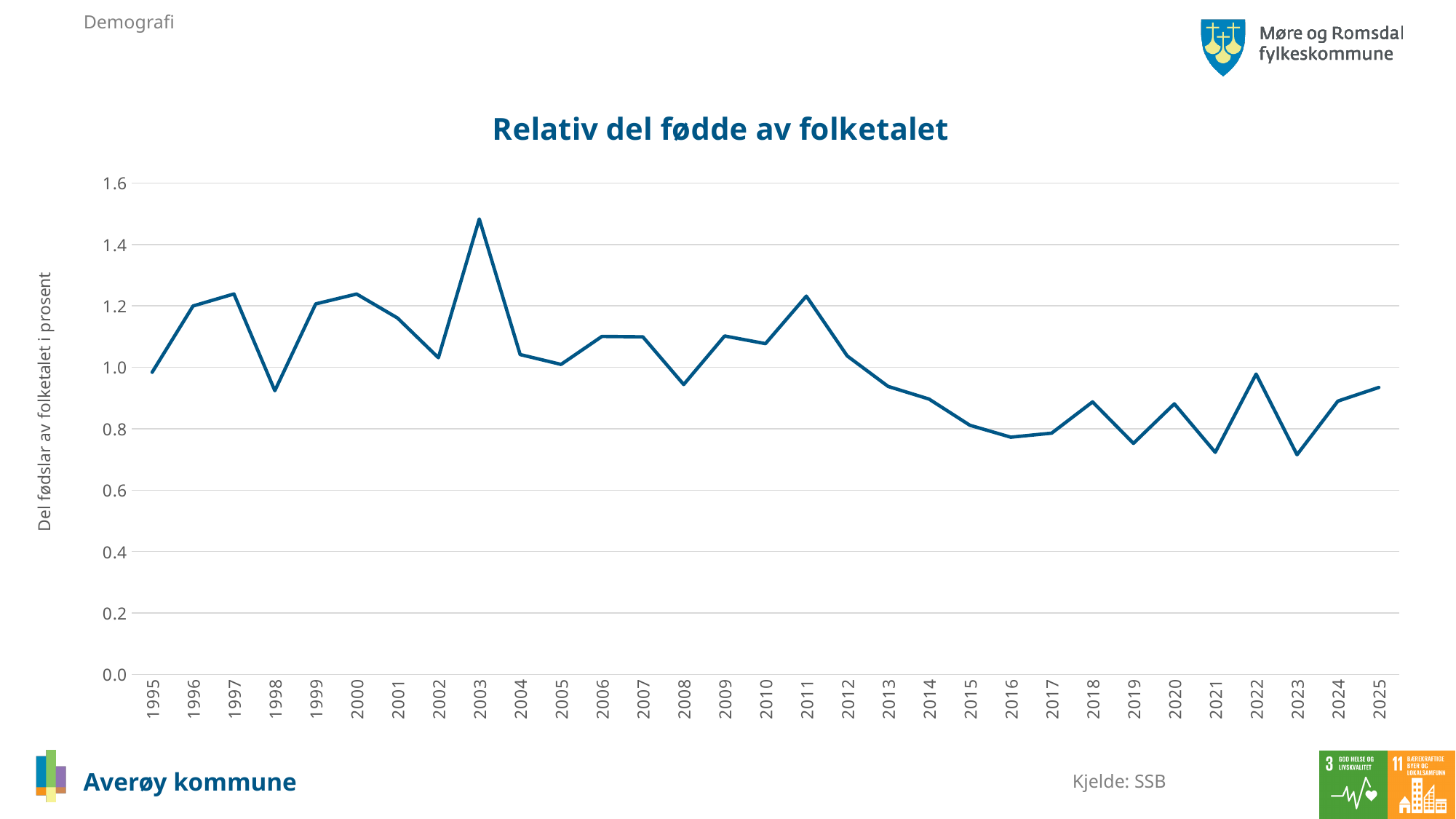
Is the value for 2008 greater or less than 1.0? less Which is larger, the value for 2003 or the value for 2023? 2003 How many years are plotted along the x axis? 31 What kind of chart is shown on the slide? line chart Is the value for 2003 greater or less than 1.4? greater Is the value for 2021 greater or less than 0.8? less Which year has the highest value? 2003 What is the label on the y axis? Del fødslar av folketalet i prosent Which is larger, the value for 2011 or the value for 2016? 2011 Do the values rise or fall from 2011 to 2016? fall What is the title of the chart? Relativ del fødde av folketalet